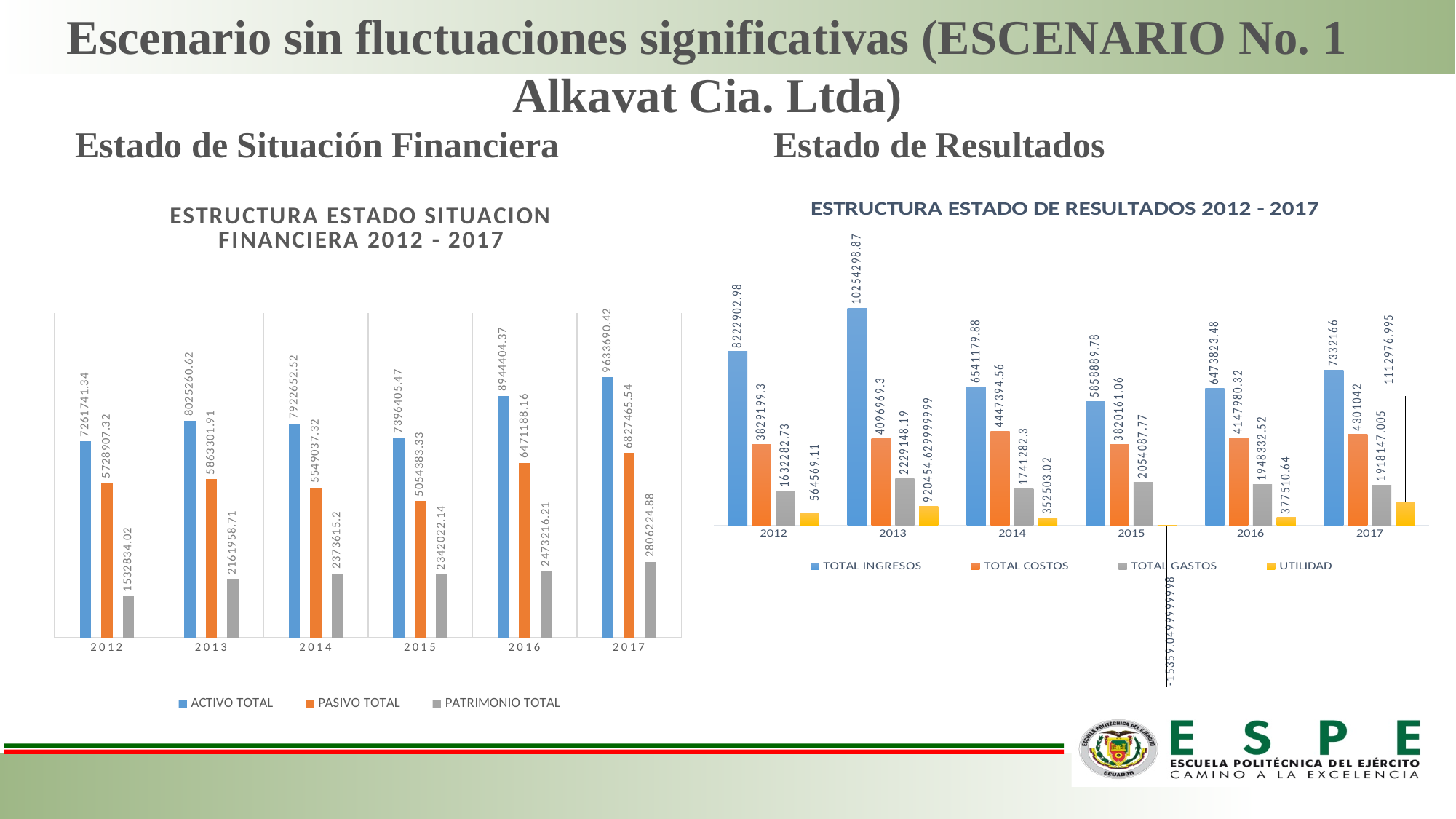
How many years are shown on the x axis of the ESTRUCTURA ESTADO DE RESULTADOS chart? 6 How many series does the legend of the ESTRUCTURA ESTADO SITUACION FINANCIERA chart list? 3 In the ESTRUCTURA ESTADO DE RESULTADOS chart, which series is shown in yellow? UTILIDAD In the ESTRUCTURA ESTADO DE RESULTADOS chart, what is the difference between TOTAL INGRESOS and TOTAL COSTOS in 2012? 4393703.68 In the ESTRUCTURA ESTADO DE RESULTADOS 2012 - 2017 chart, what is the TOTAL INGRESOS value for 2013? 10254298.87 In the ESTRUCTURA ESTADO SITUACION FINANCIERA chart, is PASIVO TOTAL larger in 2014 or in 2015? 2014 In the ESTRUCTURA ESTADO DE RESULTADOS chart, which year has the highest TOTAL INGRESOS? 2013 In the ESTRUCTURA ESTADO SITUACION FINANCIERA chart, which year has the lowest PATRIMONIO TOTAL? 2012 In the ESTRUCTURA ESTADO SITUACION FINANCIERA chart, what is the ACTIVO TOTAL value for 2017? 9633690.42 In the ESTRUCTURA ESTADO SITUACION FINANCIERA chart, what is the PATRIMONIO TOTAL value for 2014? 2373615.2 In the ESTRUCTURA ESTADO SITUACION FINANCIERA chart, what is the difference between ACTIVO TOTAL and PASIVO TOTAL in 2017? 2806224.88 What type of chart is the ESTRUCTURA ESTADO SITUACION FINANCIERA 2012 - 2017 chart? bar chart